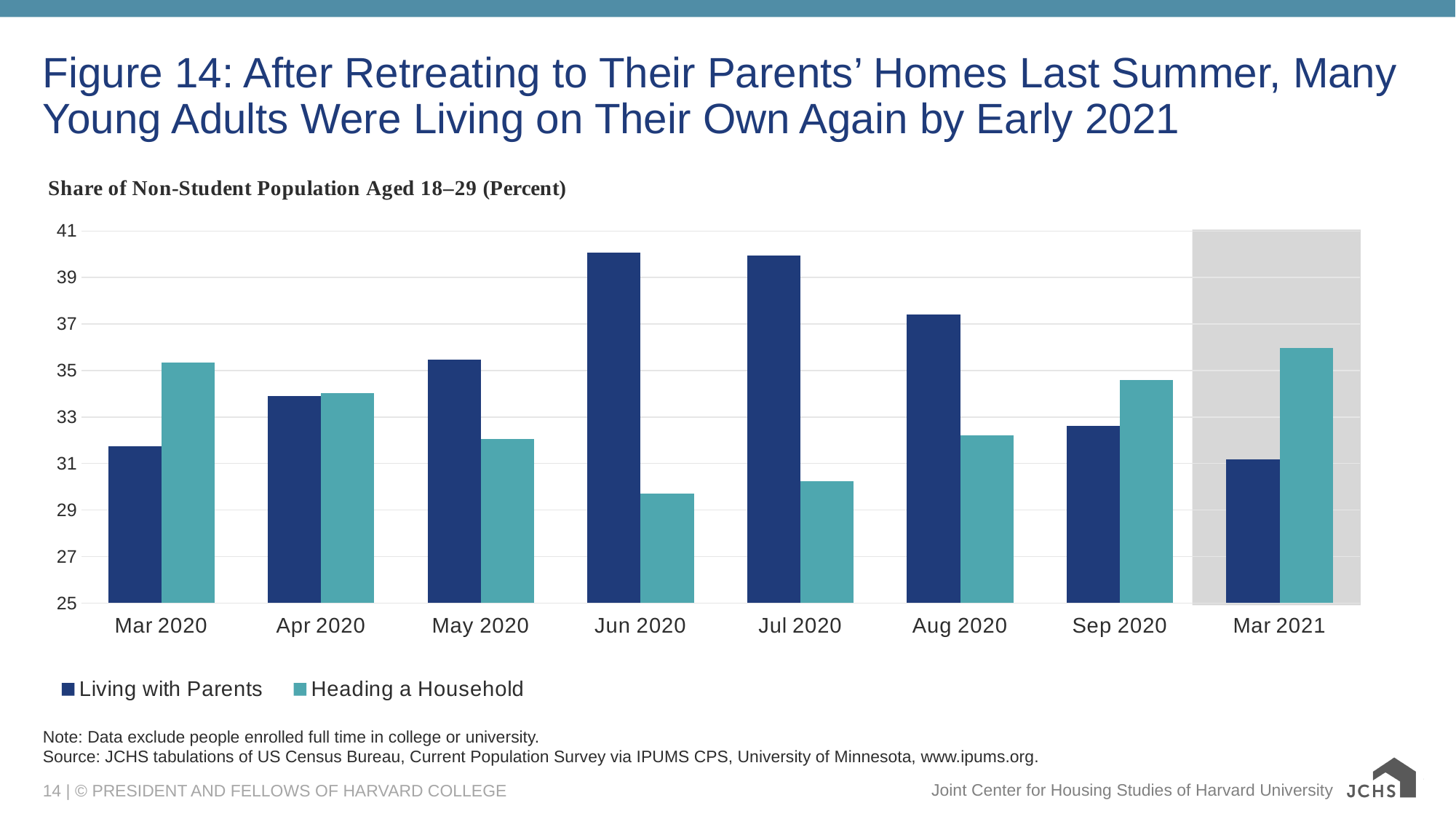
Which series is shown in dark blue in the legend? Living with Parents Is the value for Living with Parents in Jun 2020 greater or less than 39? greater Is the value for Heading a Household in Jun 2020 greater or less than 31? less Is the value for Heading a Household in Mar 2021 greater or less than 35? greater How many time periods are shown on the x axis? 8 How many series does the legend list? 2 In Jun 2020, which is larger: Living with Parents or Heading a Household? Living with Parents In Mar 2020, which is larger: Living with Parents or Heading a Household? Heading a Household Does the Living with Parents series rise or fall from Mar 2020 to Jun 2020? Rise What kind of chart is shown on the slide? Bar chart